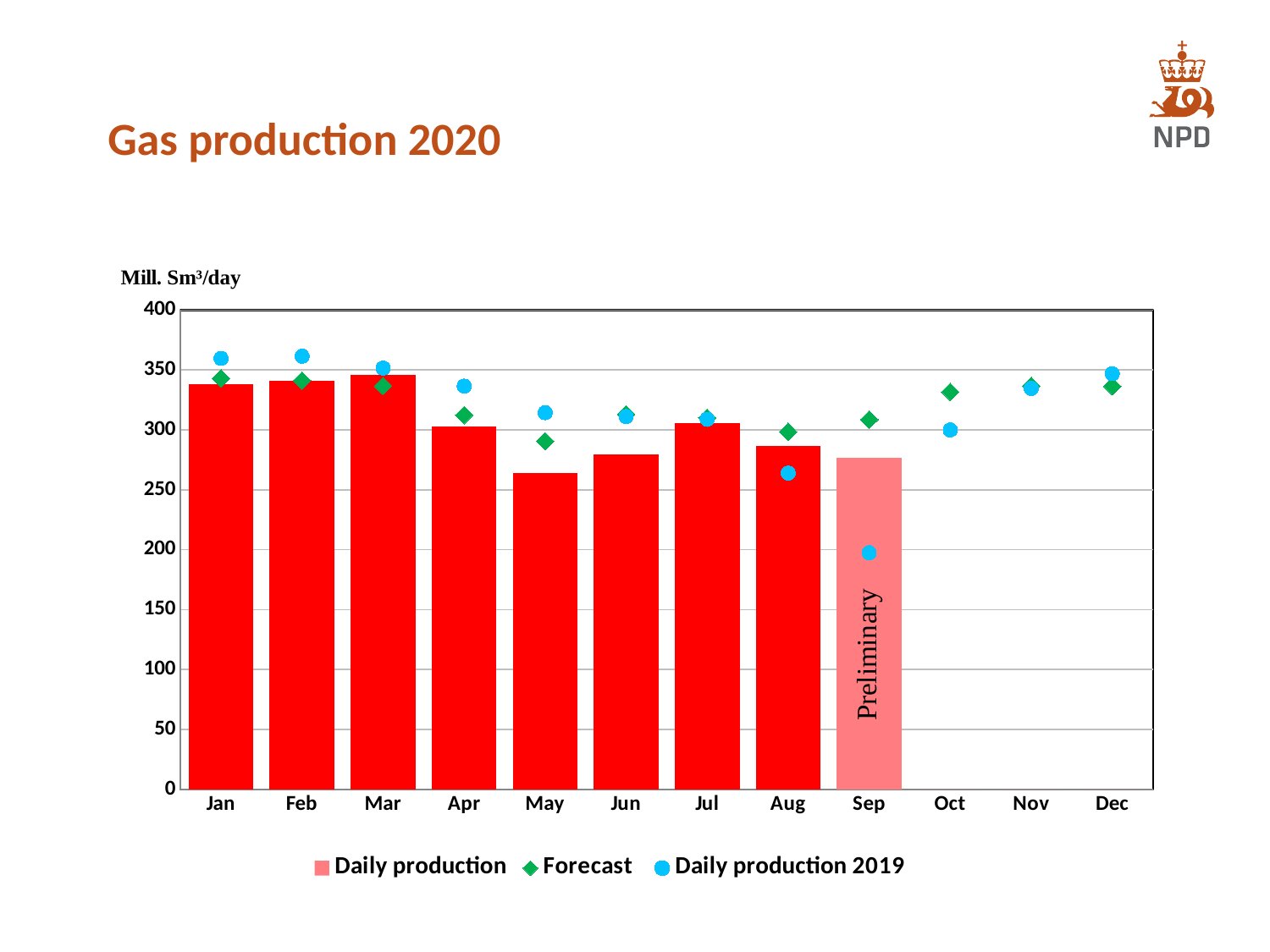
Which month has the lowest Forecast value? May Is the Daily production 2019 value for Sep greater or less than 250? less Is the Daily production value for May greater or less than 300? less How many months are shown on the x axis? 12 How many series does the legend list? 3 Is the Daily production value for Jan greater or less than 300? greater Which month has the lowest Daily production 2019 value? Sep Which is larger in Sep, the Forecast value or the Daily production 2019 value? Forecast Which month has the lowest Daily production bar? May What kind of chart is shown on the slide? bar chart Do the Daily production bars rise or fall from Jan to May? fall For how many months is a Daily production bar plotted? 9